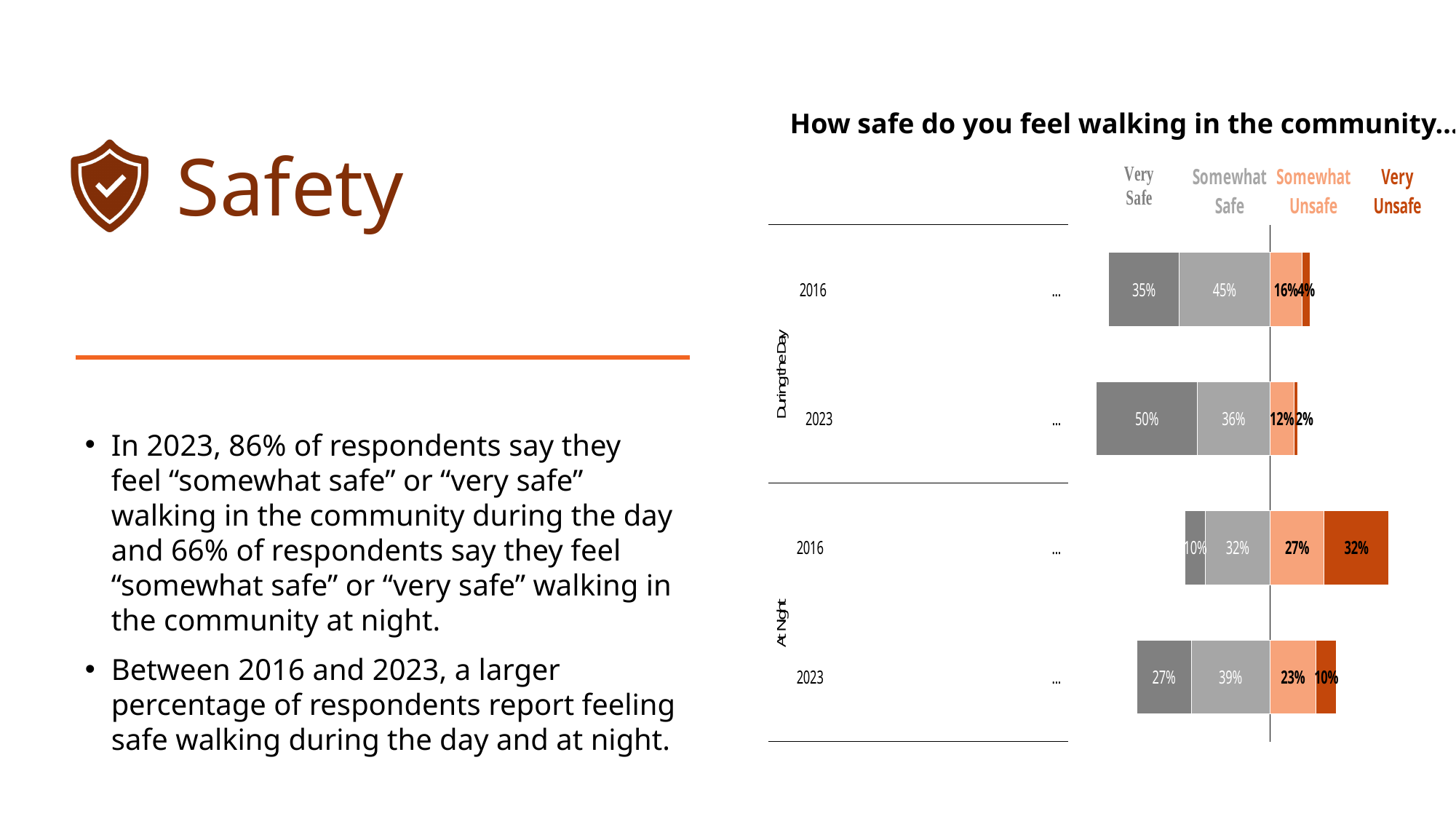
What percentage of respondents felt "Very Safe" walking during the day in 2023? 50% What kind of chart is shown on the slide? Stacked bar chart What percentage of respondents felt "Somewhat Safe" walking during the day in 2016? 45% What is the title of the chart? How safe do you feel walking in the community... Which is larger: the "Very Safe" share during the day in 2016 or at night in 2023? During the day in 2016 Which year and time of day has the highest "Very Safe" percentage? During the Day, 2023 How many series does the chart's legend list? 4 What percentage of respondents felt "Very Unsafe" walking at night in 2016? 32% What percentage of respondents felt "Somewhat Unsafe" walking at night in 2023? 23% By how many percentage points did the "Very Unsafe" share at night fall from 2016 to 2023? 22 percentage points How many bars are plotted in the chart? 4 Which year and time of day has the lowest "Very Safe" percentage? At Night, 2016